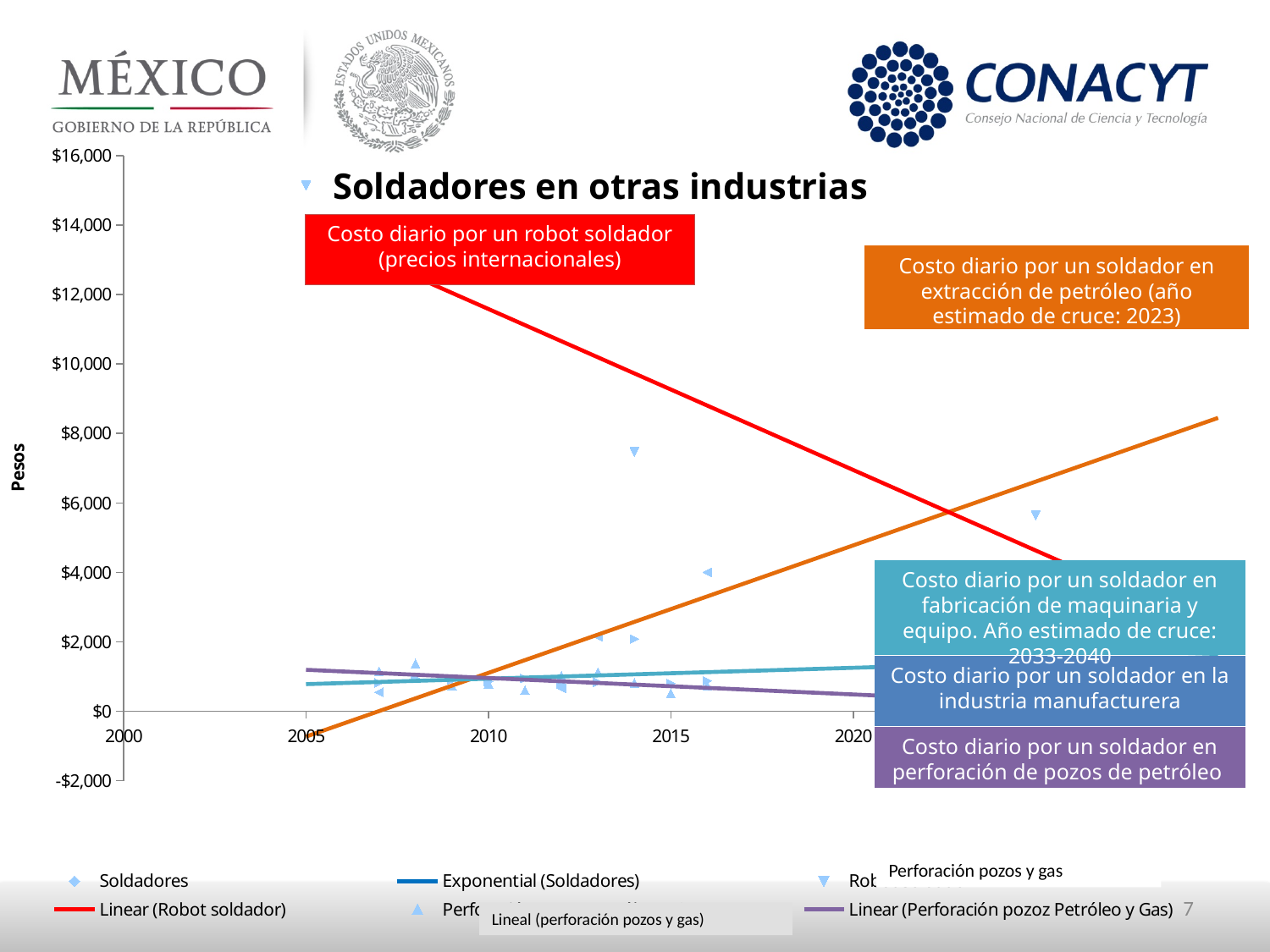
Is the value of the purple 'Linear (Perforación pozoz Petróleo y Gas)' line at 2005 greater or less than $2,000? less What is the label of the vertical axis? Pesos Does the orange line for the welder in oil extraction rise or fall along the x axis? rise What is the title of the chart? Soldadores en otras industrias What is the lowest value shown on the vertical axis? -$2,000 Does the red 'Linear (Robot soldador)' line rise or fall from 2005 to 2020? fall What is the highest value shown on the vertical axis? $16,000 Is the value of the robot welder point plotted near 2014 greater or less than $6,000? greater What kind of chart is shown on the slide? scatter chart Is the value of the red 'Linear (Robot soldador)' line at 2010 greater or less than $10,000? greater At 2015, which is higher: the red 'Linear (Robot soldador)' line or the orange oil-extraction welder line? the red Linear (Robot soldador) line At 2020, which is higher: the orange oil-extraction welder line or the red 'Linear (Robot soldador)' line? the orange oil-extraction welder line